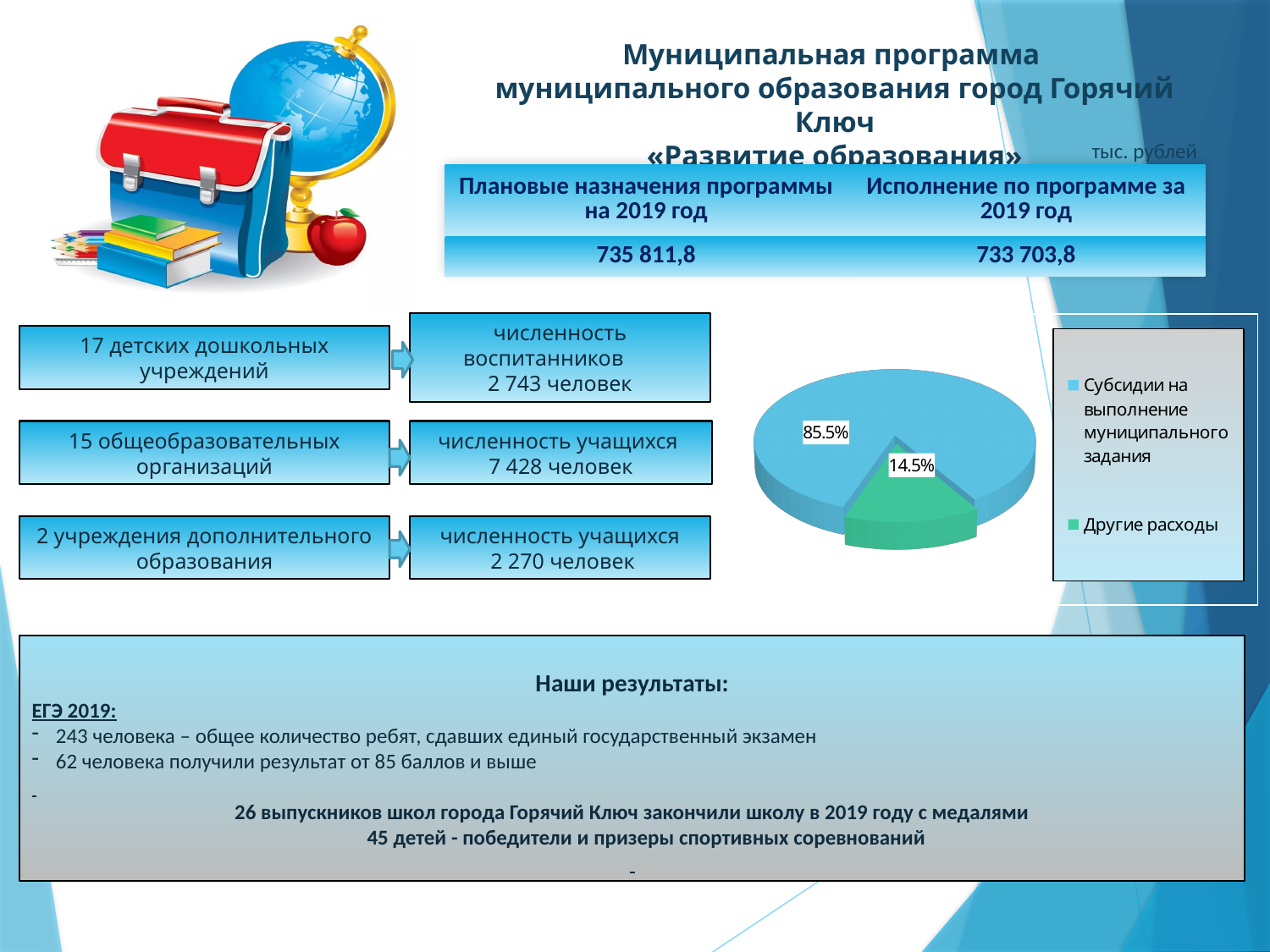
What share of the pie chart is labelled "Другие расходы"? 14.5% Which is larger in the pie chart: "Субсидии на выполнение муниципального задания" or "Другие расходы"? Субсидии на выполнение муниципального задания What is the difference in percentage points between the "Субсидии на выполнение муниципального задания" slice and the "Другие расходы" slice? 71 percentage points What colour is the "Субсидии на выполнение муниципального задания" slice in the pie chart? blue How many entries does the pie chart legend list? 2 How many slices does the pie chart have? 2 Which slice of the pie chart is the largest? Субсидии на выполнение муниципального задания What colour is the "Другие расходы" slice in the pie chart? green Which slice of the pie chart is the smallest? Другие расходы What kind of chart is shown on the slide? pie chart What share of the pie chart is labelled "Субсидии на выполнение муниципального задания"? 85.5%